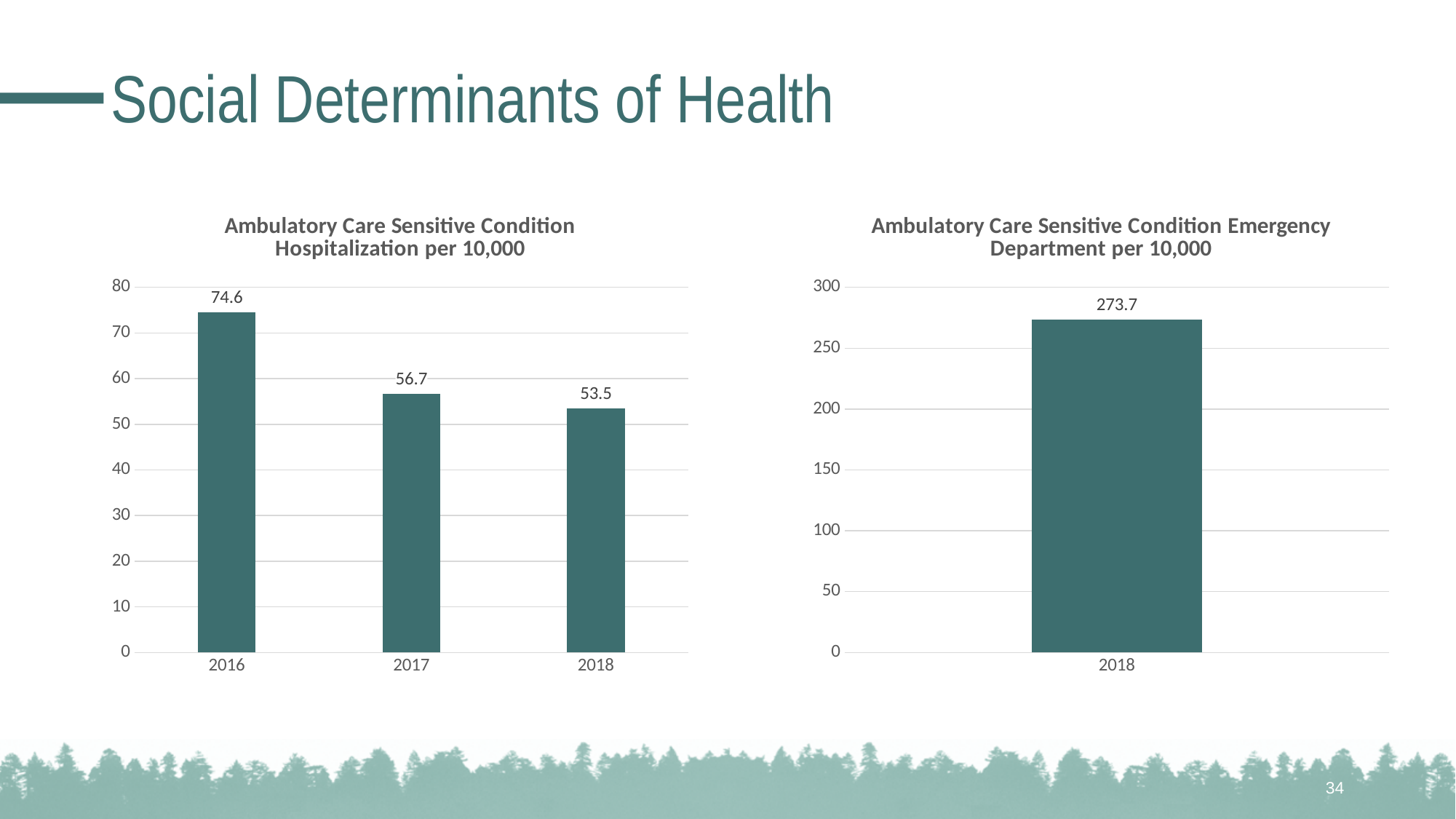
In the 'Ambulatory Care Sensitive Condition Hospitalization per 10,000' chart, which year has the highest value? 2016 In the 'Ambulatory Care Sensitive Condition Hospitalization per 10,000' chart, what is the value for 2017? 56.7 In the 'Ambulatory Care Sensitive Condition Hospitalization per 10,000' chart, which is larger, the value for 2016 or 2017? 2016 How many years are shown in the 'Ambulatory Care Sensitive Condition Hospitalization per 10,000' chart? 3 In the 'Ambulatory Care Sensitive Condition Emergency Department per 10,000' chart, what is the value for 2018? 273.7 In the 'Ambulatory Care Sensitive Condition Hospitalization per 10,000' chart, do the values rise or fall from 2016 to 2018? Fall In the 'Ambulatory Care Sensitive Condition Hospitalization per 10,000' chart, what is the value for 2016? 74.6 In the 'Ambulatory Care Sensitive Condition Hospitalization per 10,000' chart, which year has the lowest value? 2018 In the 'Ambulatory Care Sensitive Condition Hospitalization per 10,000' chart, what is the value for 2018? 53.5 What kind of chart is the 'Ambulatory Care Sensitive Condition Emergency Department per 10,000' chart? Bar chart In the 'Ambulatory Care Sensitive Condition Emergency Department per 10,000' chart, is the value for 2018 greater or less than 250? greater In the 'Ambulatory Care Sensitive Condition Hospitalization per 10,000' chart, what is the difference between the 2016 and 2018 values? 21.1